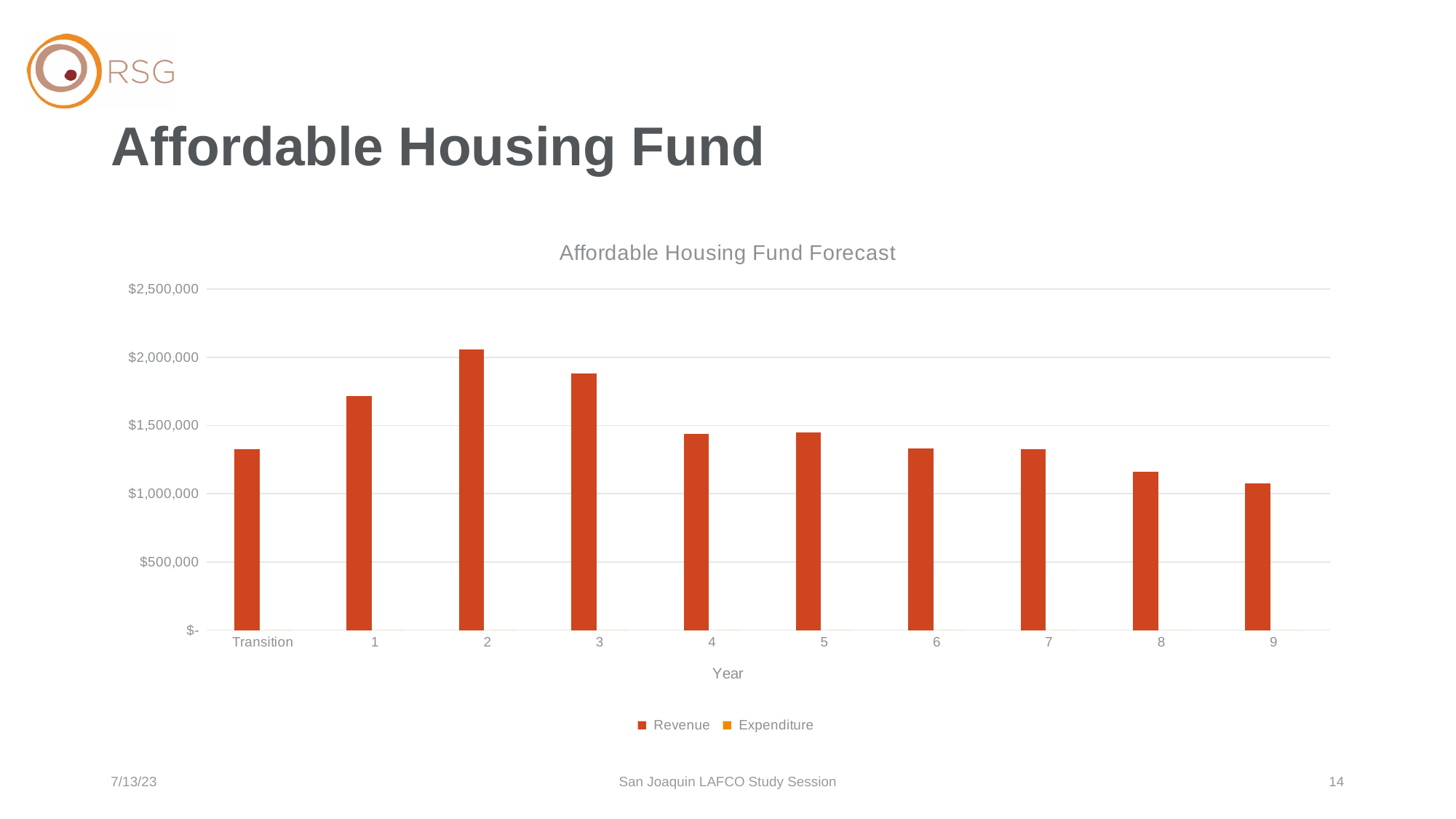
Which has the larger Revenue value, year 1 or year 3? 3 How many series does the chart legend list? 2 Is the Revenue value for year 9 greater or less than $1,000,000? greater Which year has the highest Revenue bar? 2 Is the Revenue value for year 8 greater or less than $1,500,000? less Do the Revenue values rise or fall from year 3 to year 9? fall What is the title of the chart? Affordable Housing Fund Forecast What kind of chart is shown on the slide? bar chart Is the Revenue value for year 1 greater or less than $1,500,000? greater How many categories are shown along the x axis? 10 Which year has the lowest Revenue bar? 9